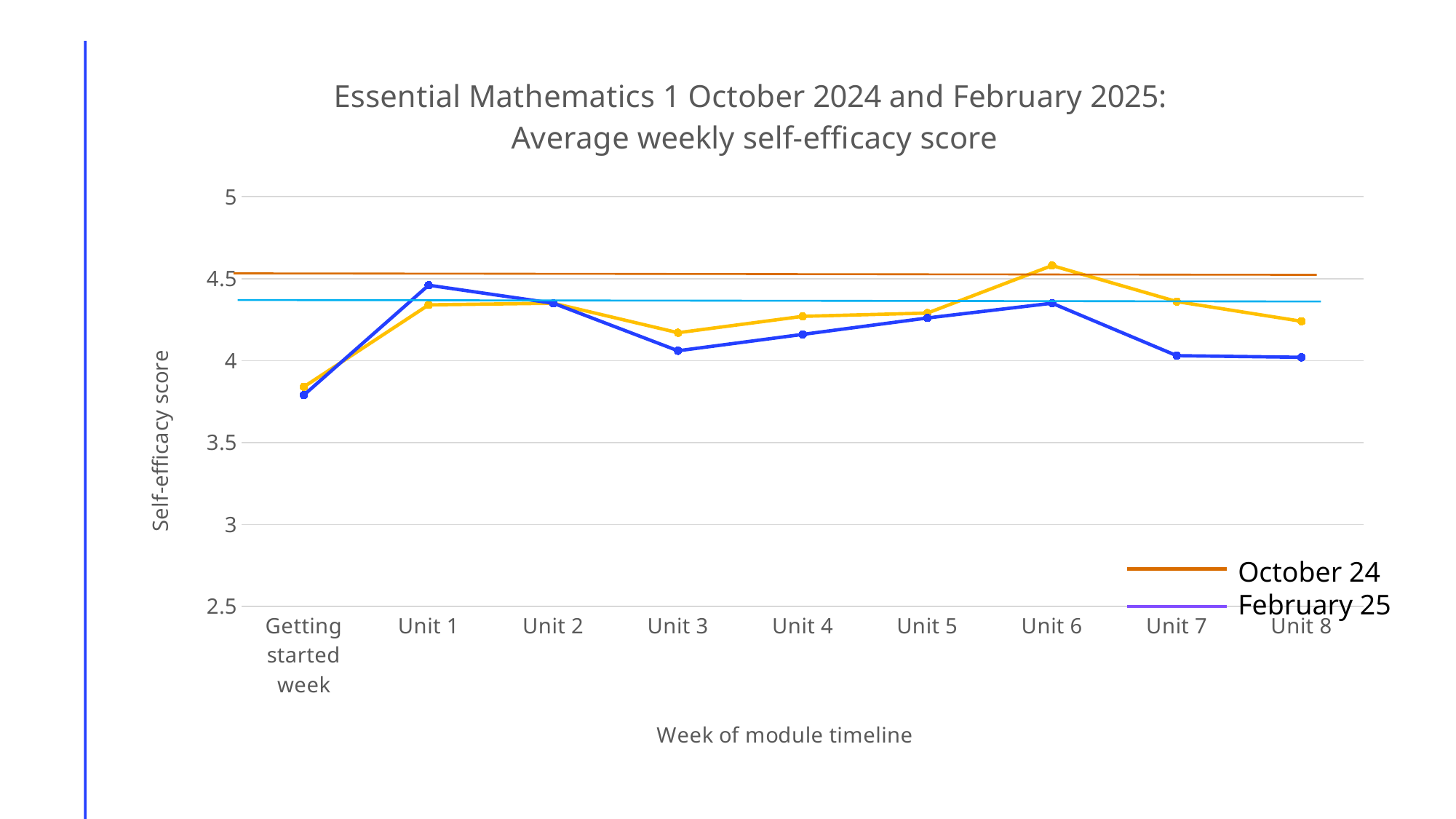
At Unit 7, which series has the higher value, October 24 or February 25? October 24 How many categories are shown along the x axis? 9 At which week does the February 25 series reach its highest value? Unit 1 How many series does the legend list? 2 What kind of chart is shown on the slide? Line chart Does the February 25 series rise or fall from Unit 6 to Unit 8? Fall Is the October 24 value for Unit 6 greater or less than 4.5? greater Is the October 24 value for Unit 3 greater or less than 4? greater What is the label on the y axis? Self-efficacy score Is the February 25 value for the Getting started week greater or less than 4? less At which week is the February 25 series at its lowest value? Getting started week At which week does the October 24 series reach its highest value? Unit 6